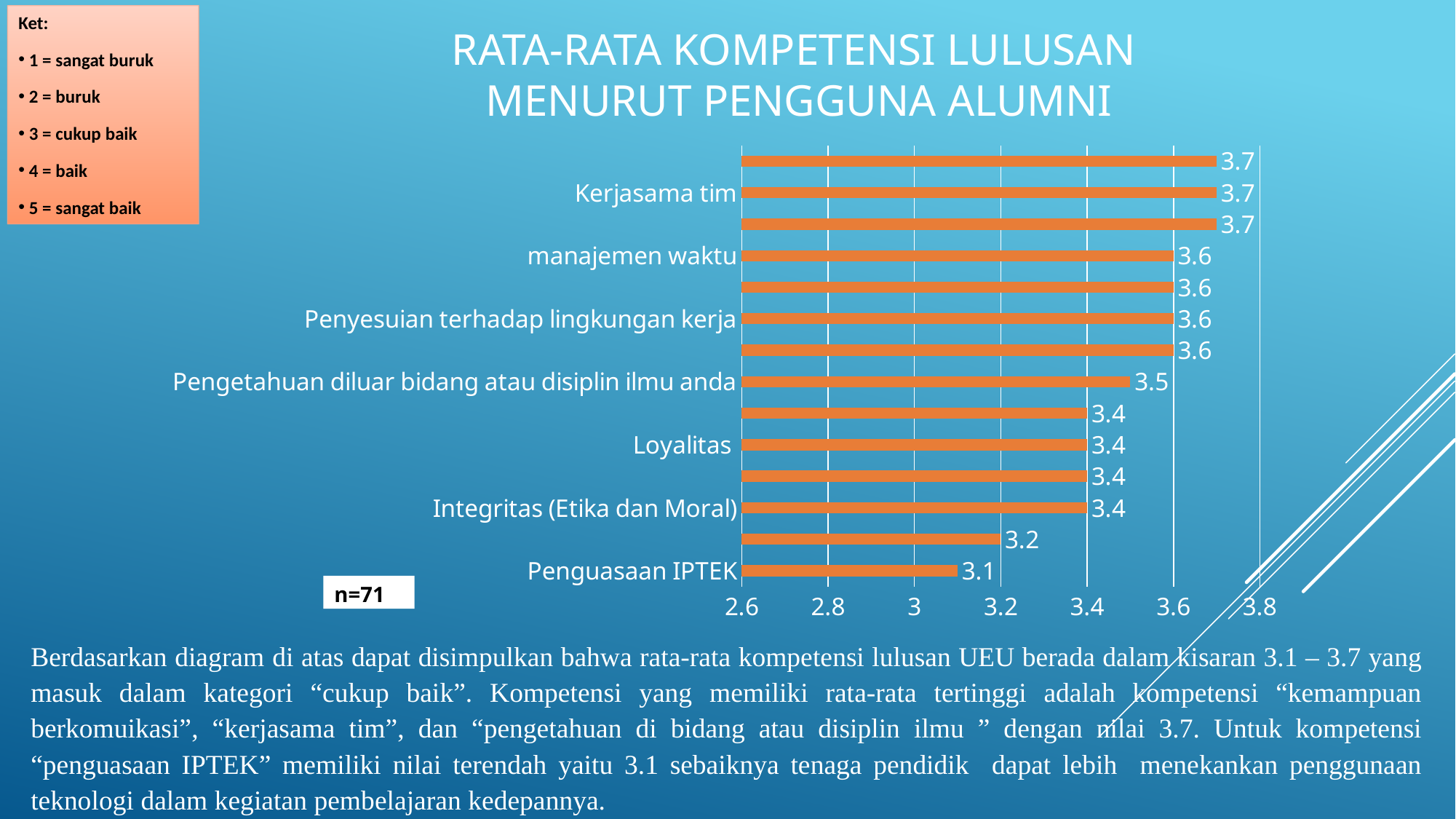
Is the value for Penguasaan IPTEK greater or less than 3.2? less What is the value for Kerjasama tim? 3.7 What kind of chart is shown on the slide? bar chart What is the value for manajemen waktu? 3.6 How many bars are plotted in the chart? 14 What is the value for Loyalitas? 3.4 What is the difference between the values for Kerjasama tim and Penguasaan IPTEK? 0.6 Which labelled category has the lowest value? Penguasaan IPTEK What sample size (n) is shown on the slide? n=71 Which is larger, the value for Integritas (Etika dan Moral) or the value for Penyesuian terhadap lingkungan kerja? Penyesuian terhadap lingkungan kerja What is the value for Pengetahuan diluar bidang atau disiplin ilmu anda? 3.5 What is the value for Penguasaan IPTEK? 3.1